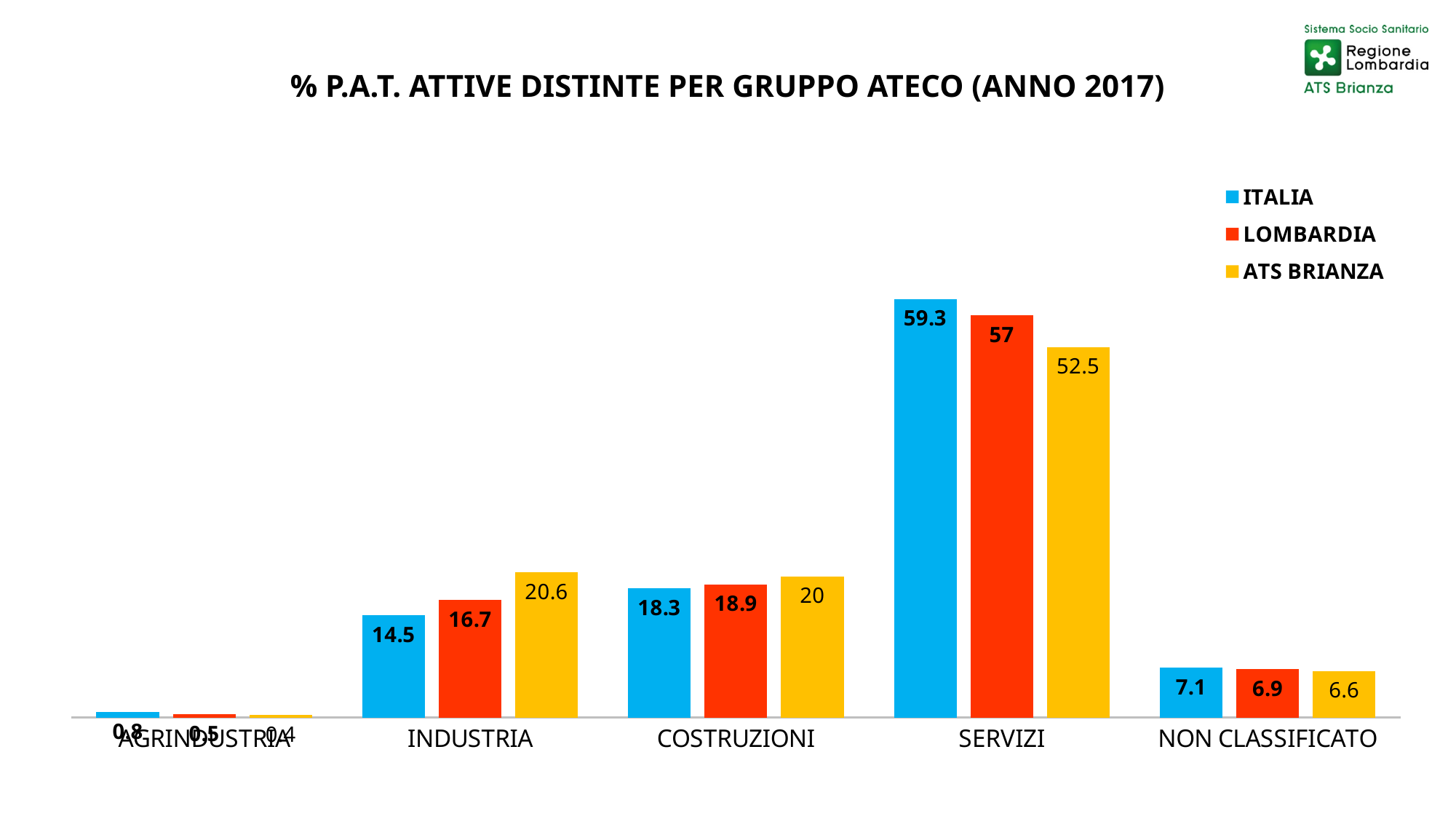
What is the ATS BRIANZA value for NON CLASSIFICATO? 6.6 Which category has the highest ITALIA value? SERVIZI What is the ITALIA value for SERVIZI? 59.3 What is the difference between the ATS BRIANZA and ITALIA values for INDUSTRIA? 6.1 What is the difference between the ITALIA and ATS BRIANZA values for SERVIZI? 6.8 What kind of chart is shown on the slide? Bar chart What is the ATS BRIANZA value for INDUSTRIA? 20.6 How many categories are shown on the x axis? 5 For SERVIZI, which is larger: the ITALIA value or the LOMBARDIA value? ITALIA How many series does the legend list? 3 What is the LOMBARDIA value for COSTRUZIONI? 18.9 Which category has the lowest LOMBARDIA value? AGRINDUSTRIA